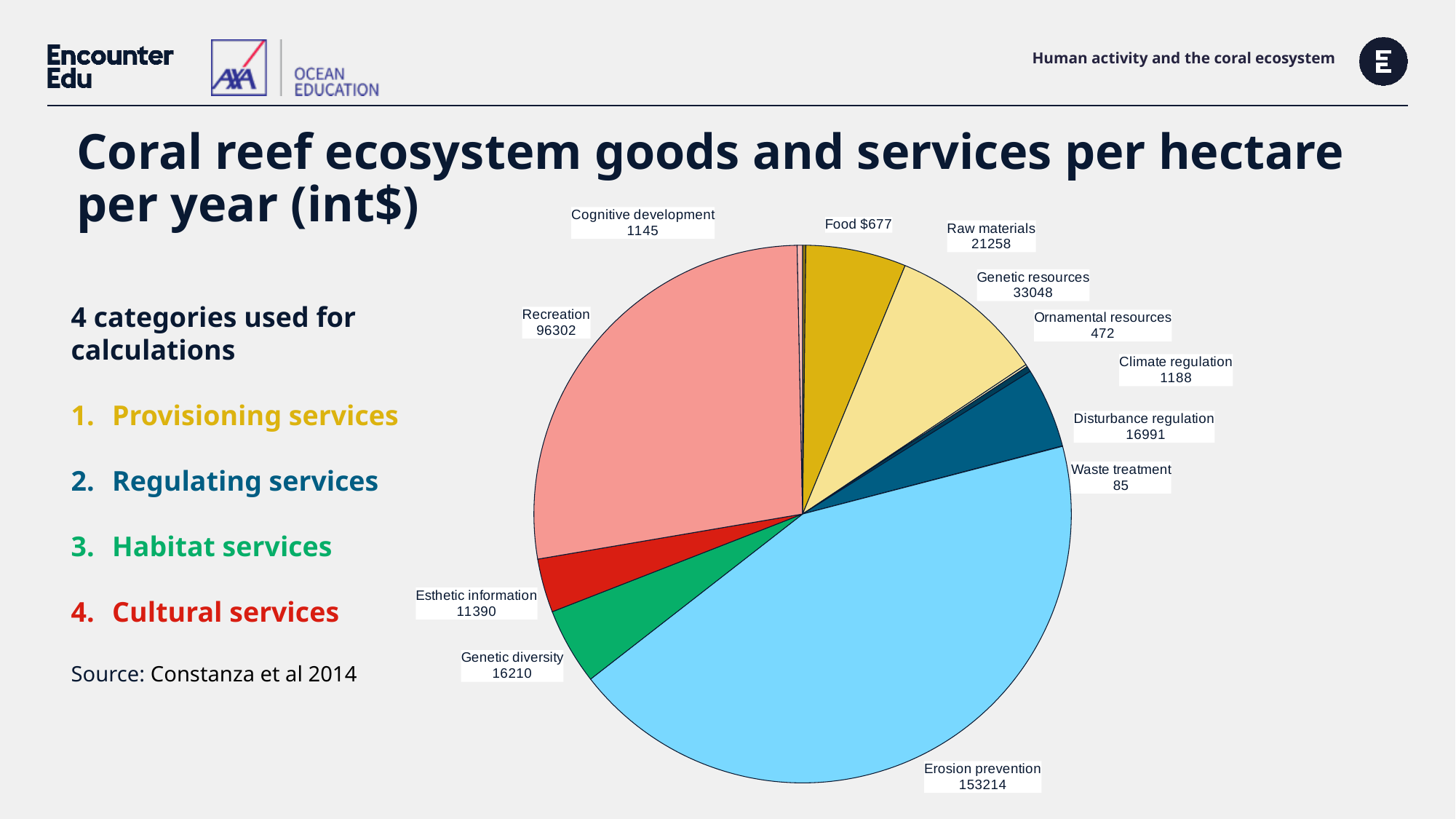
What is the value for Genetic resources? 33048 What is the difference between the values for Erosion prevention and Recreation? 56912 What type of chart is shown on the slide? Pie chart What is the value for Waste treatment? 85 How many categories are shown in the pie chart? 12 Which is larger, Recreation or Genetic resources? Recreation Which category has the largest slice of the pie? Erosion prevention Which category has the smallest value? Waste treatment What is the value for Erosion prevention? 153214 What is the difference between the values for Genetic resources and Raw materials? 11790 What is the value for Recreation? 96302 What is the title of the chart on the slide? Coral reef ecosystem goods and services per hectare per year (int$)